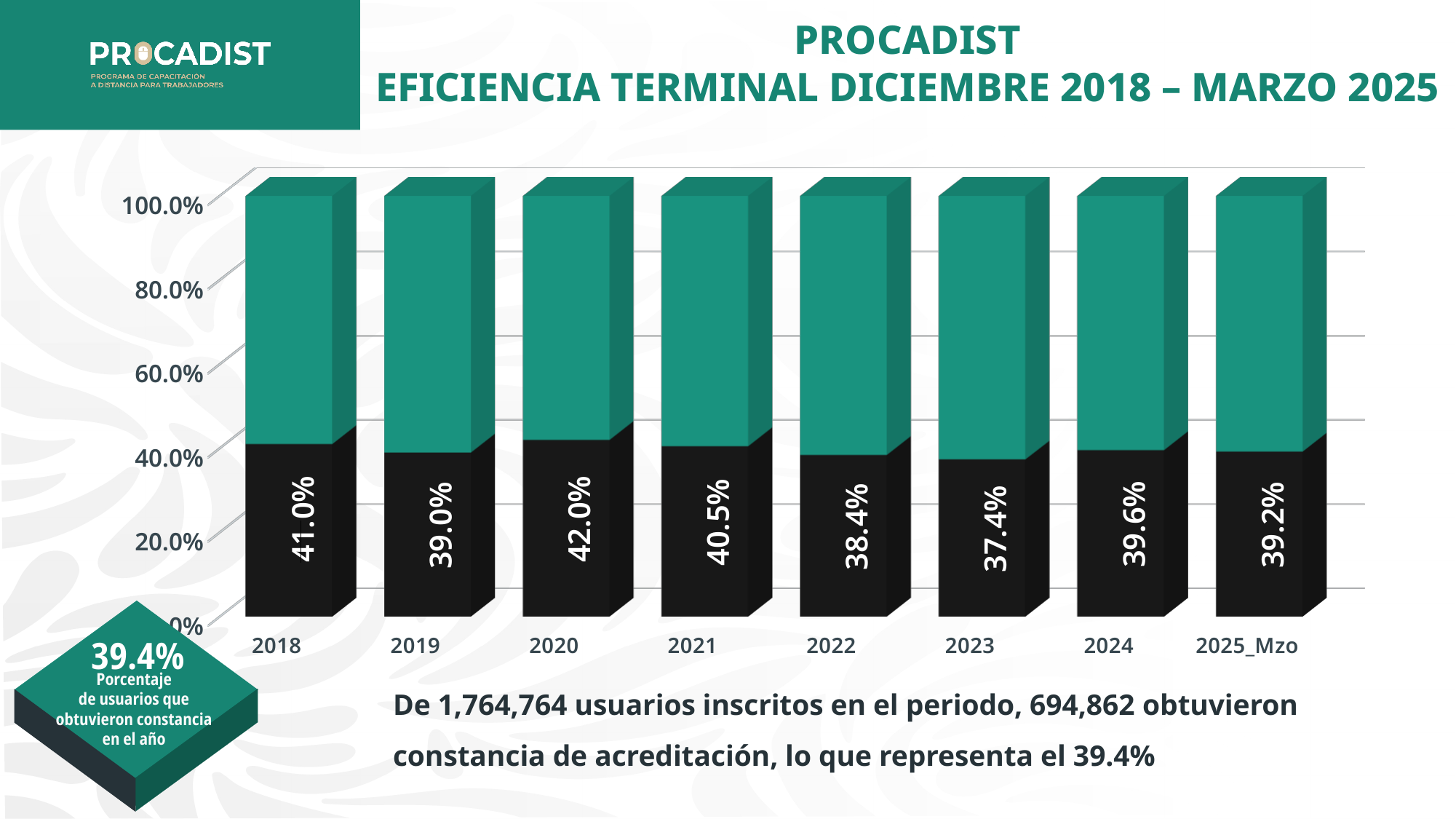
What is the labelled value for 2018? 41.0% What is the labelled value for 2022? 38.4% Which year has the highest labelled percentage? 2020 Which is larger, the labelled value for 2021 or for 2022? 2021 What is the title of the chart? PROCADIST EFICIENCIA TERMINAL DICIEMBRE 2018 – MARZO 2025 What kind of chart is shown on the slide? Stacked bar chart Is the labelled value for 2023 greater or less than 40.0%? less Which year has the lowest labelled percentage? 2023 What is the difference between the labelled values for 2024 and 2019? 0.6 percentage points How many years (categories) are shown on the x axis? 8 What is the labelled value for 2025_Mzo? 39.2% What is the difference between the labelled values for 2020 and 2023? 4.6 percentage points